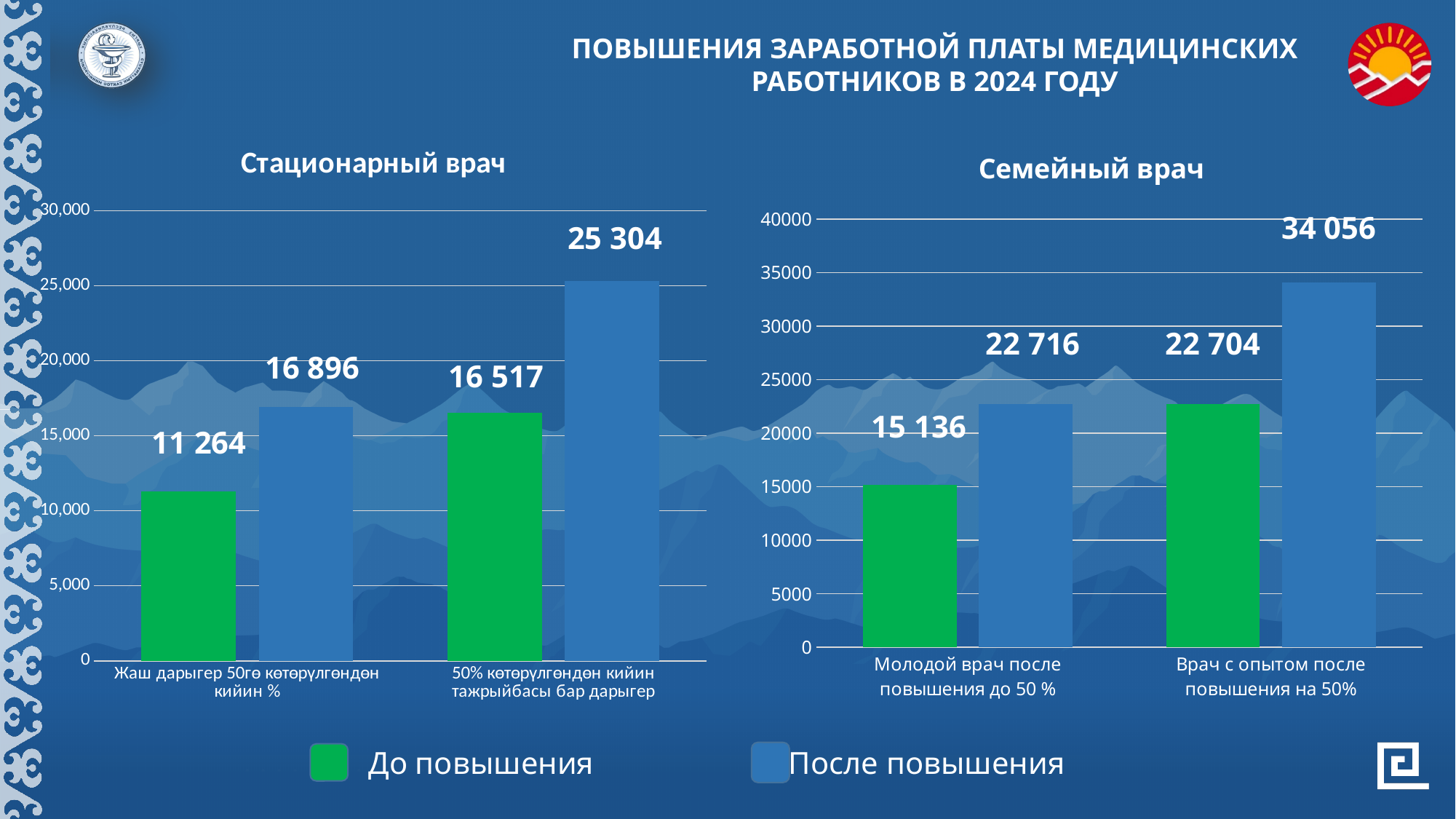
How many series does the legend list? 2 How many categories are shown in the 'Семейный врач' chart? 2 In the 'Семейный врач' chart, what is the 'До повышения' value for 'Молодой врач после повышения до 50 %'? 15 136 In the 'Семейный врач' chart, what is the 'После повышения' value for 'Врач с опытом после повышения на 50%'? 34 056 In the 'Семейный врач' chart, what is the difference between the 'После повышения' and 'До повышения' values for 'Врач с опытом после повышения на 50%'? 11 352 In the 'Семейный врач' chart, is the 'После повышения' value for 'Молодой врач после повышения до 50 %' larger or smaller than the 'До повышения' value for 'Врач с опытом после повышения на 50%'? larger What type of chart is the 'Стационарный врач' chart? bar chart In the 'Стационарный врач' chart, what is the 'До повышения' value for 'Жаш дарыгер 50гө көтөрүлгөндөн кийин %'? 11 264 In the 'Стационарный врач' chart, what is the difference between the 'После повышения' and 'До повышения' values for 'Жаш дарыгер 50гө көтөрүлгөндөн кийин %'? 5 632 In the 'Стационарный врач' chart, which bar has the lowest value? До повышения for Жаш дарыгер 50гө көтөрүлгөндөн кийин % In the 'Стационарный врач' chart, what is the 'После повышения' value for '50% көтөрүлгөндөн кийин тажрыйбасы бар дарыгер'? 25 304 In the 'Семейный врач' chart, which bar has the highest value? После повышения for Врач с опытом после повышения на 50%